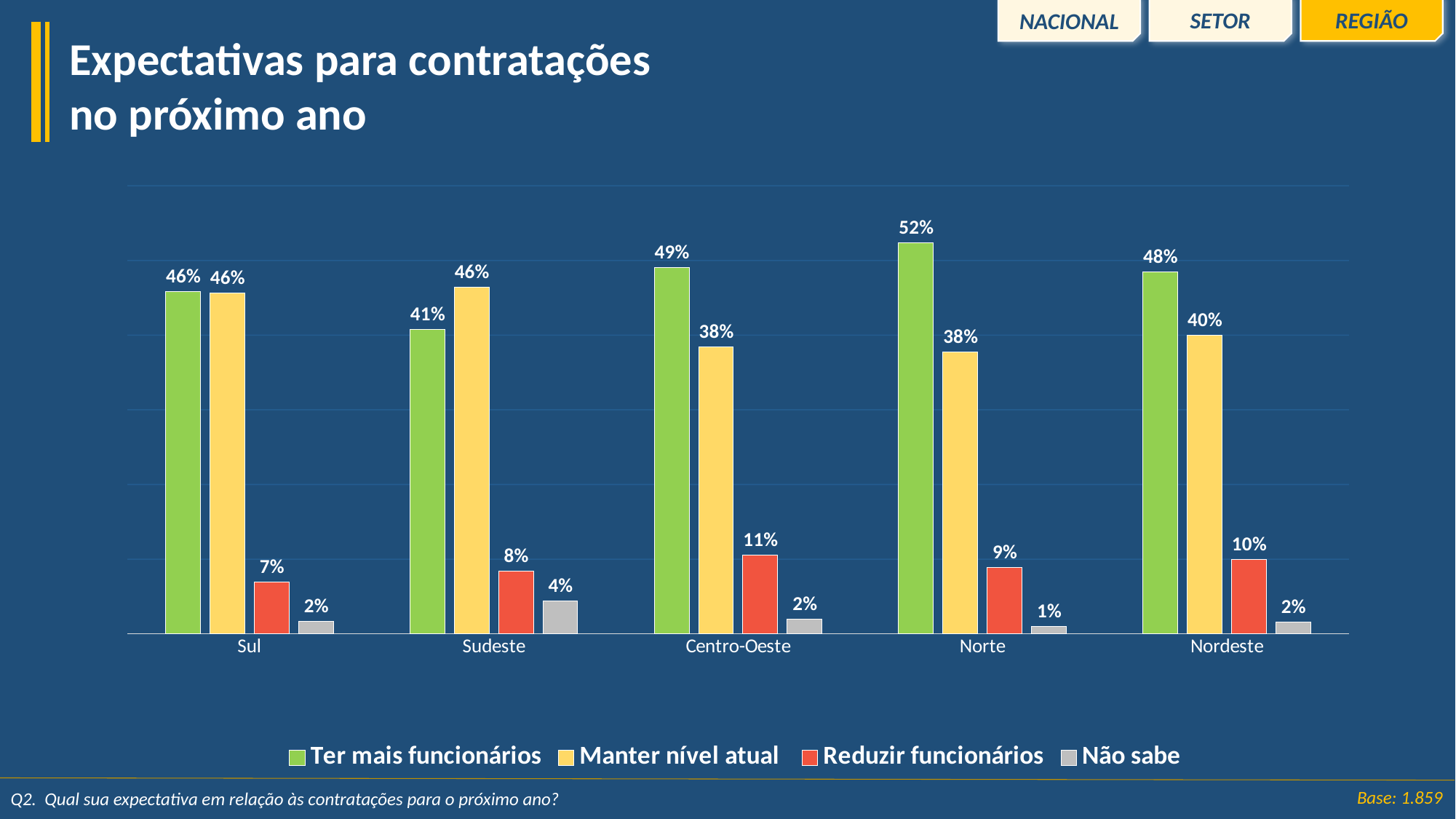
What is the difference between "Ter mais funcionários" and "Manter nível atual" in Norte? 14% Which is larger in Sudeste: "Ter mais funcionários" or "Manter nível atual"? Manter nível atual How many regions are shown on the x axis? 5 Which region has the lowest value for "Não sabe"? Norte What kind of chart is shown on the slide? Bar chart How many series does the legend list? 4 What is the value for "Não sabe" in Sudeste? 4% Which colour represents "Reduzir funcionários" in the legend? Red What is the value for "Manter nível atual" in Nordeste? 40% What is the value for "Reduzir funcionários" in Centro-Oeste? 11% Which region has the highest value for "Ter mais funcionários"? Norte What is the value for "Ter mais funcionários" in Norte? 52%